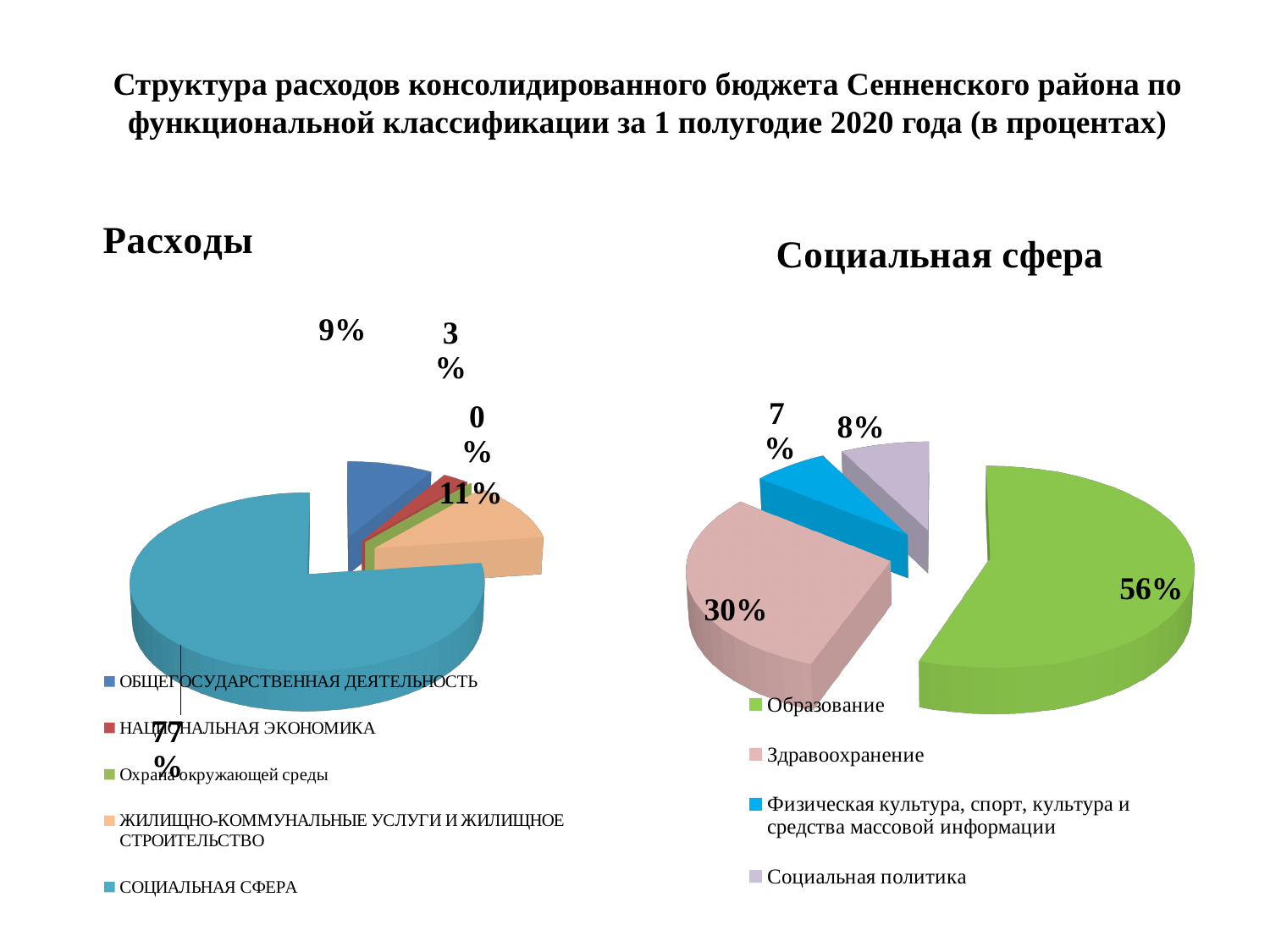
In the "Социальная сфера" chart, what share does Здравоохранение have? 30% In the "Социальная сфера" chart, which category has the largest share? Образование In the "Социальная сфера" chart, what share does Социальная политика have? 8% In the "Социальная сфера" chart, what is the difference between the shares of Образование and Здравоохранение? 26% In the "Расходы" chart, which category has the largest share? СОЦИАЛЬНАЯ СФЕРА What kind of chart is the "Социальная сфера" chart? Pie chart In the "Расходы" chart, what share does СОЦИАЛЬНАЯ СФЕРА have? 77% In the "Расходы" chart, what is the difference between the shares of ОБЩЕГОСУДАРСТВЕННАЯ ДЕЯТЕЛЬНОСТЬ and НАЦИОНАЛЬНАЯ ЭКОНОМИКА? 6% In the "Социальная сфера" chart, which is larger: Социальная политика or Физическая культура, спорт, культура и средства массовой информации? Социальная политика In the "Расходы" chart, what share does ЖИЛИЩНО-КОММУНАЛЬНЫЕ УСЛУГИ И ЖИЛИЩНОЕ СТРОИТЕЛЬСТВО have? 11% How many categories does the legend of the "Расходы" chart list? 5 In the "Расходы" chart, which category has the smallest share? Охрана окружающей среды